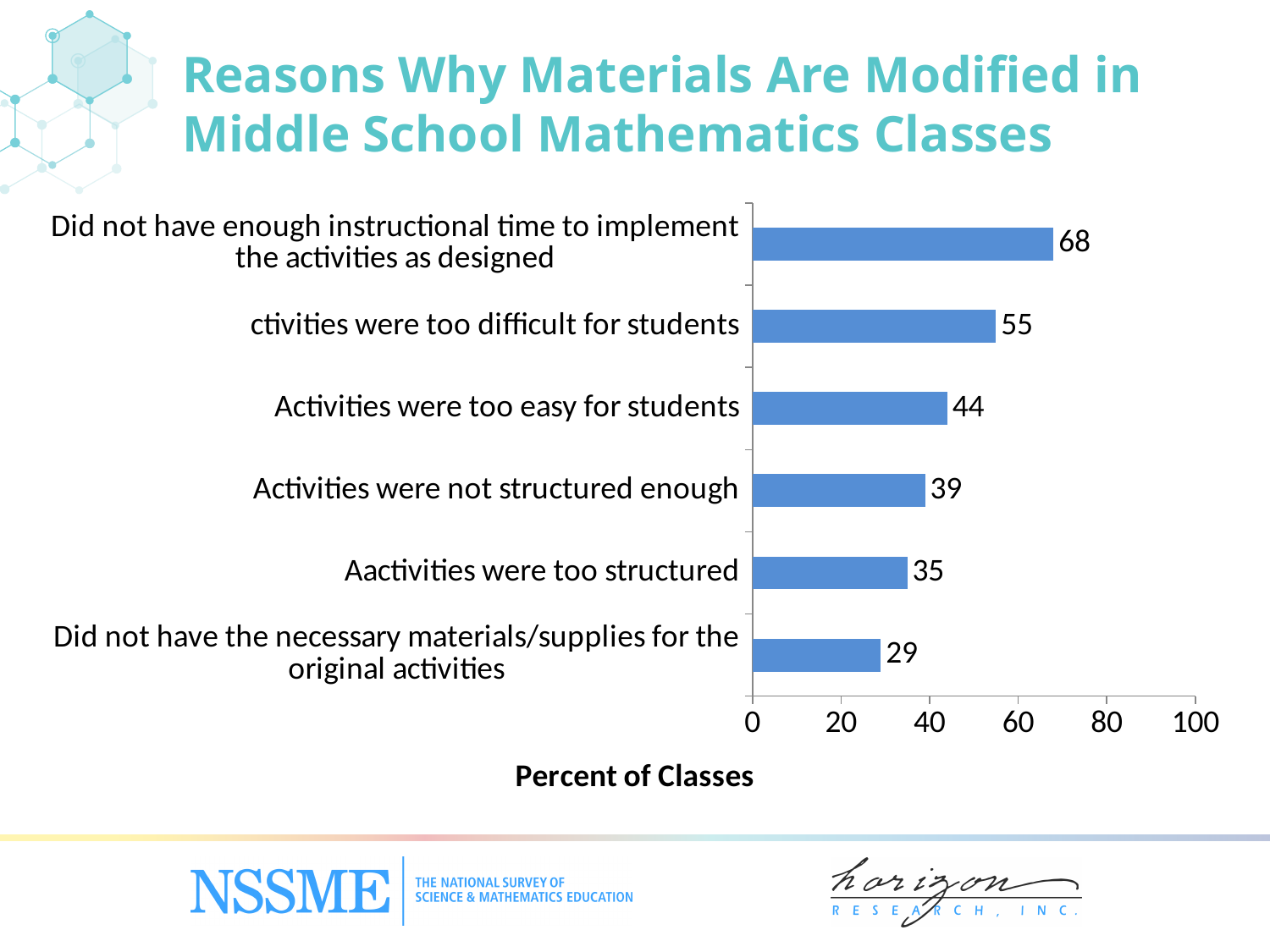
How many reasons are shown in the chart? 6 What is the value for 'Activities were not structured enough'? 39 What percent of classes modified materials because they did not have enough instructional time to implement the activities as designed? 68 What kind of chart is shown on the slide? Bar chart What is the difference between the values for 'Activities were too difficult for students' and 'Activities were too easy for students'? 11 Is the value for 'Activities were too difficult for students' greater or less than 60? less What is the value for 'Activities were too easy for students'? 44 Which is larger: the value for 'Activities were not structured enough' or 'Activities were too structured'? Activities were not structured enough What is the label of the horizontal axis? Percent of Classes What percent of classes cited not having the necessary materials/supplies for the original activities? 29 Which reason has the highest percent of classes? Did not have enough instructional time to implement the activities as designed Which reason has the lowest percent of classes? Did not have the necessary materials/supplies for the original activities